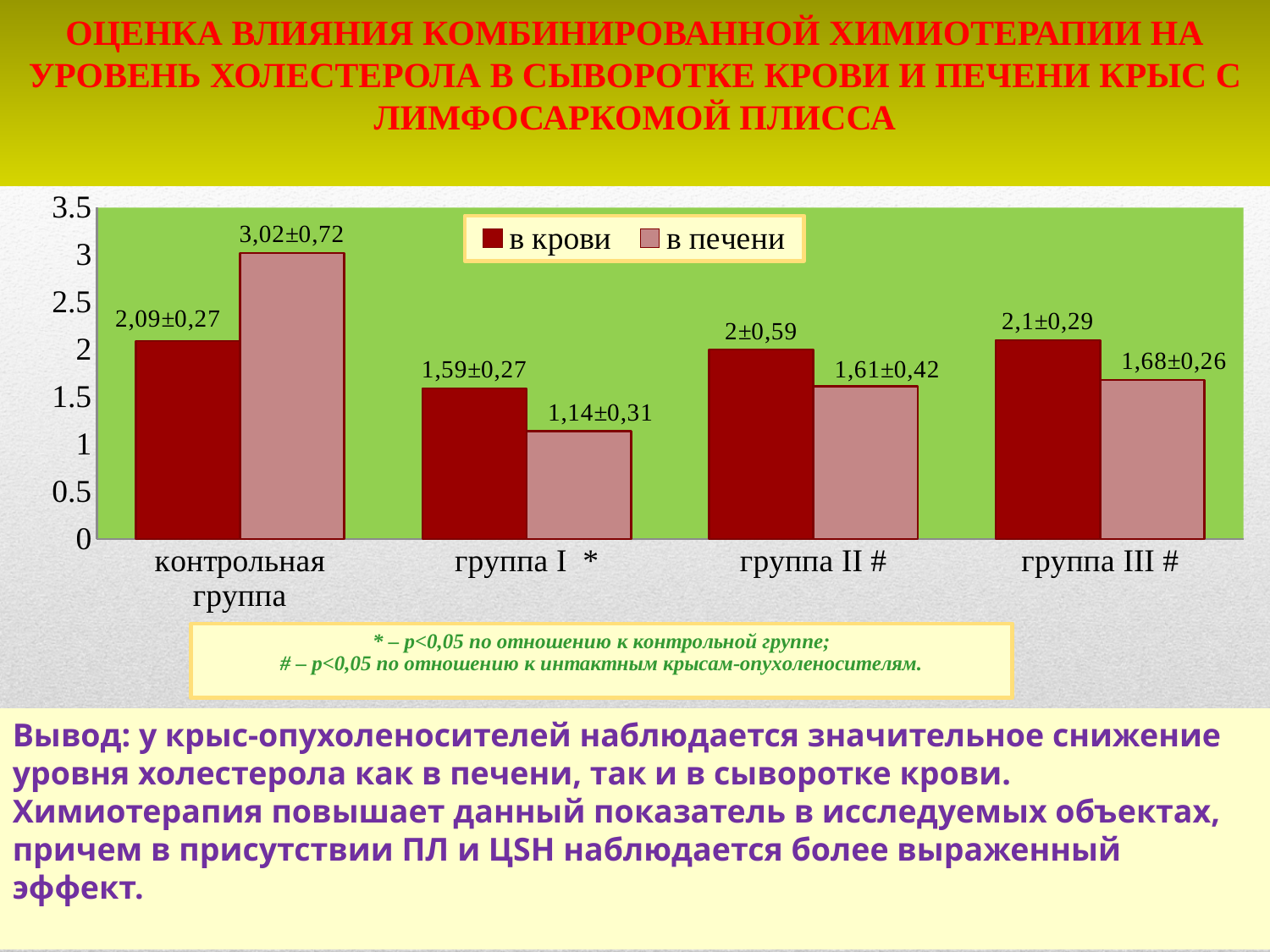
How many groups are shown on the x axis? 4 Which group has the highest value for "в печени"? контрольная группа In группа I, which is larger: the value for "в крови" or for "в печени"? в крови What is the value for "в крови" in the контрольная группа? 2,09±0,27 What is the value for "в печени" in группа III? 1,68±0,26 Which group has the lowest value for "в печени"? группа I What is the value for "в крови" in группа II? 2±0,59 What is the value for "в печени" in группа I? 1,14±0,31 How many series does the legend list? 2 Which group has the lowest value for "в крови"? группа I Is the value for "в печени" in группа I greater or less than 1.5? less What is the value for "в печени" in the контрольная группа? 3,02±0,72